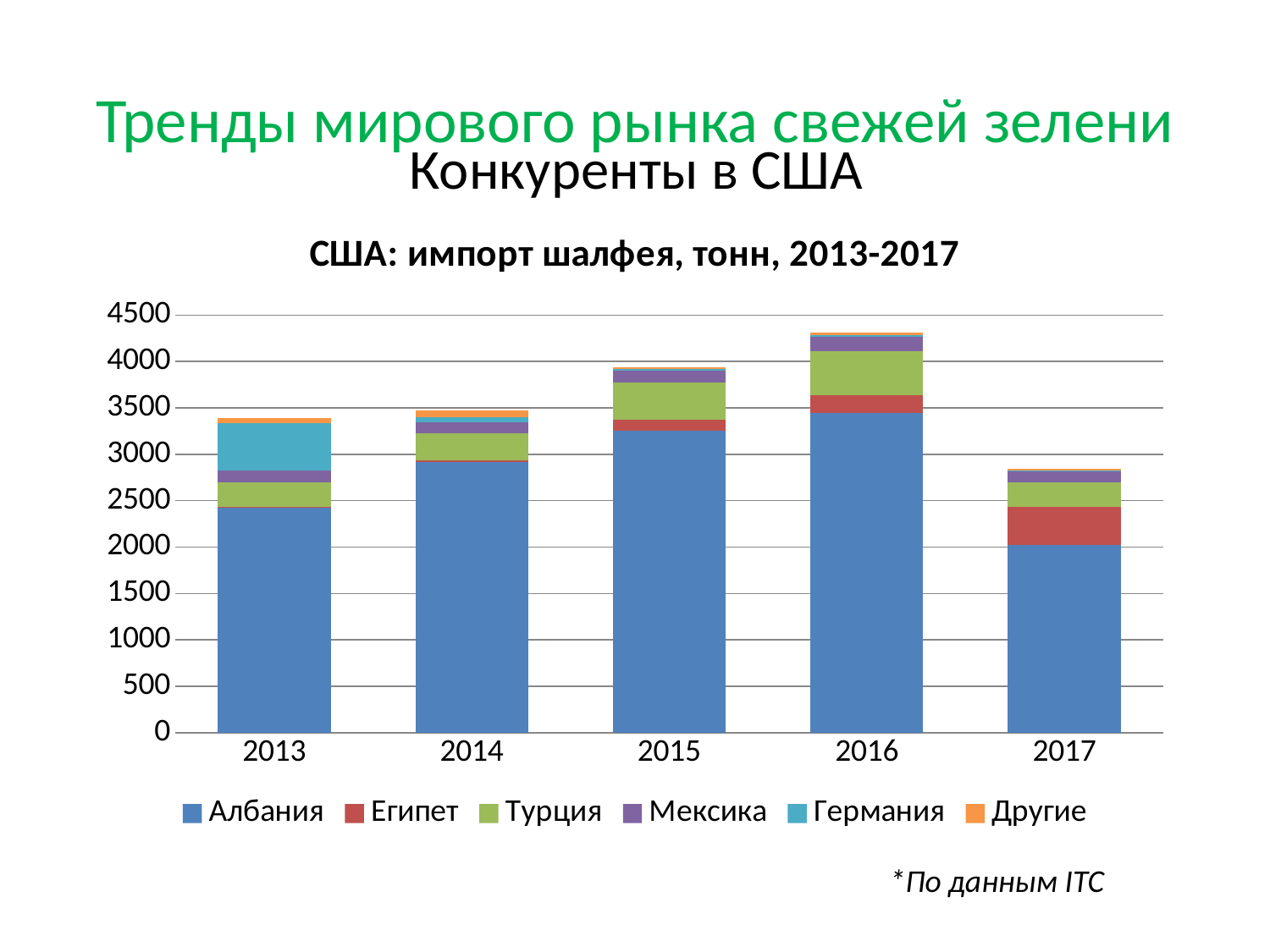
How many series does the legend of the chart list? 6 Which is larger, the total for 2013 or the total for 2017? 2013 Is the total value for 2017 greater or less than 3000? less Is the value for Албания in 2015 greater or less than 3000? greater Which year has the highest total sage import in the chart? 2016 What is the title of the chart? США: импорт шалфея, тонн, 2013-2017 Is the value for Албания in 2013 greater or less than 2500? less How many years are shown on the x axis of the chart? 5 Do the total values rise or fall from 2013 to 2016? rise Which year has the lowest total sage import in the chart? 2017 What kind of chart is shown on the slide? Stacked bar chart